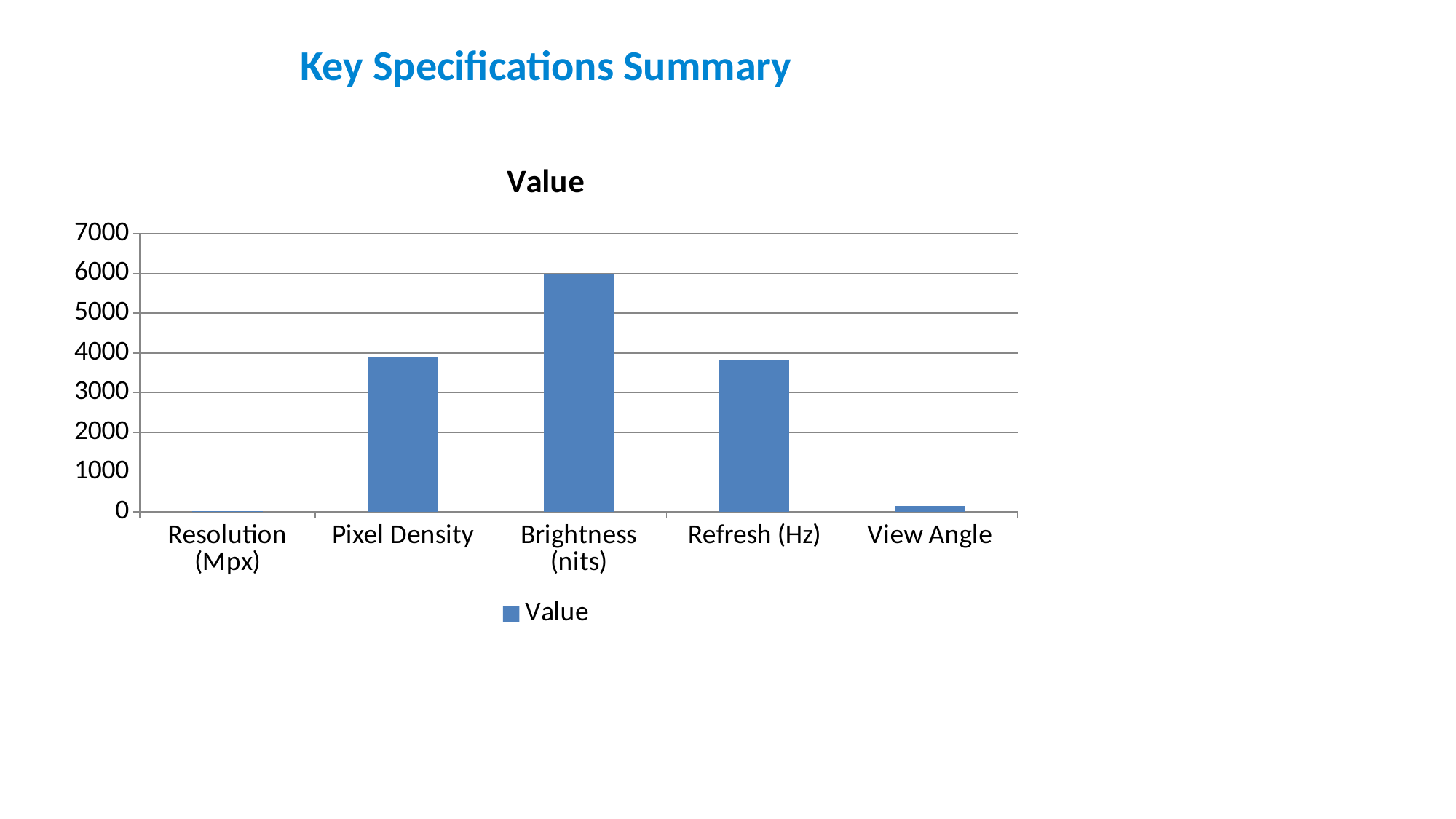
Which is larger, the value for View Angle or the value for Refresh (Hz)? Refresh (Hz) Is the value for Pixel Density greater or less than 3000? greater Is the value for View Angle greater or less than 1000? less Which is larger, the value for Brightness (nits) or the value for Pixel Density? Brightness (nits) Which category has the highest value? Brightness (nits) What is the title of the chart? Value Which category has the lowest value? Resolution (Mpx) Is the value for Refresh (Hz) greater or less than 4000? less What is the value for Brightness (nits)? 6000 What kind of chart is shown on the slide? bar chart How many series does the legend list? 1 How many categories are shown on the x axis of the chart? 5